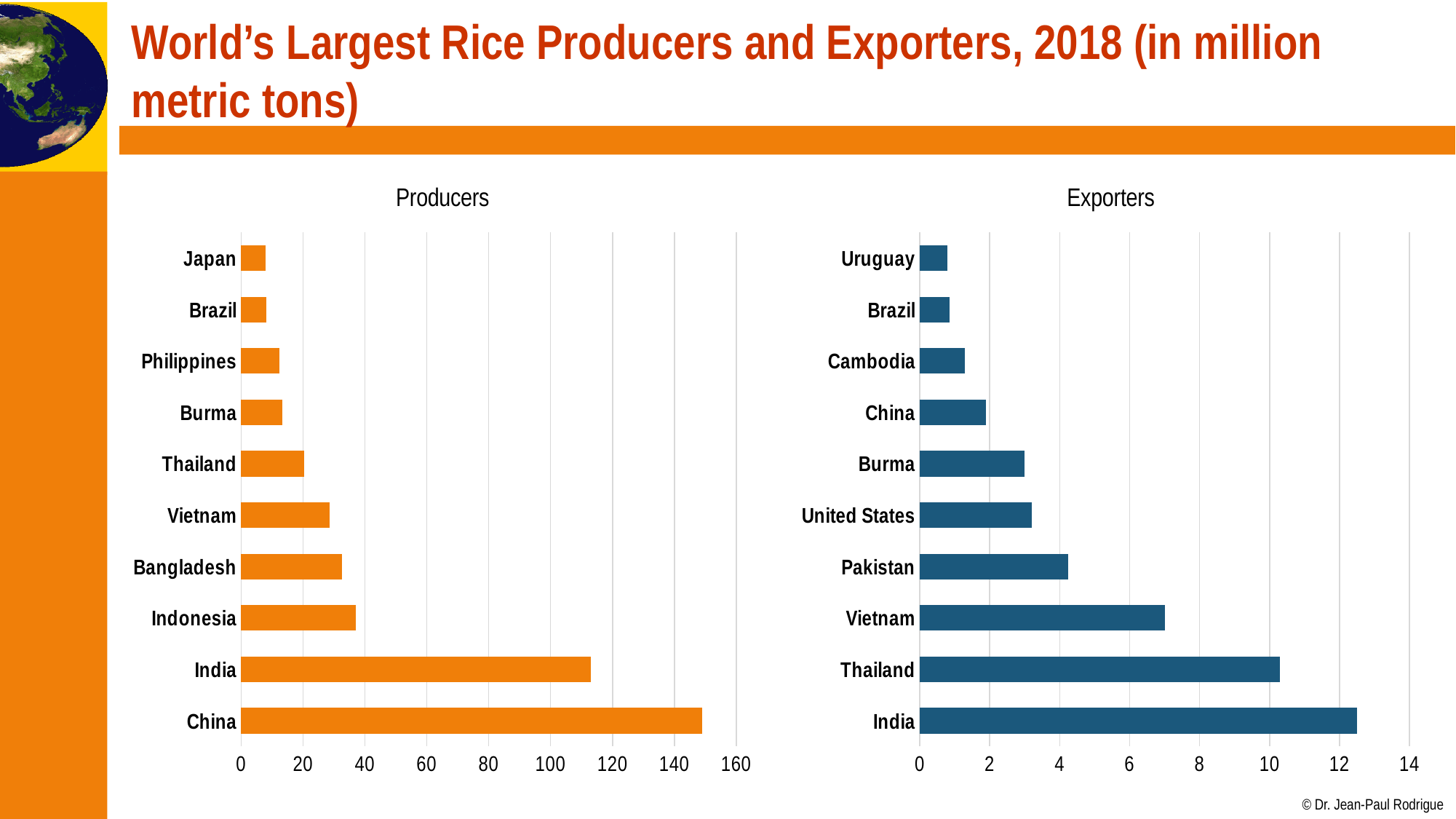
What colour are the bars in the Exporters chart? dark blue In the Exporters chart, is the value for Burma greater or less than 4? less How many countries are shown in the Exporters chart? 10 In the Producers chart, which country has the highest value? China In the Exporters chart, which country has the highest value? India In the Producers chart, is the value for India greater or less than 100? greater In the Exporters chart, is the value for Thailand greater or less than 8? greater In the Producers chart, which is larger, the value for India or the value for Indonesia? India In the Exporters chart, which is larger, the value for Vietnam or the value for Pakistan? Vietnam What kind of chart is the Producers chart? bar chart